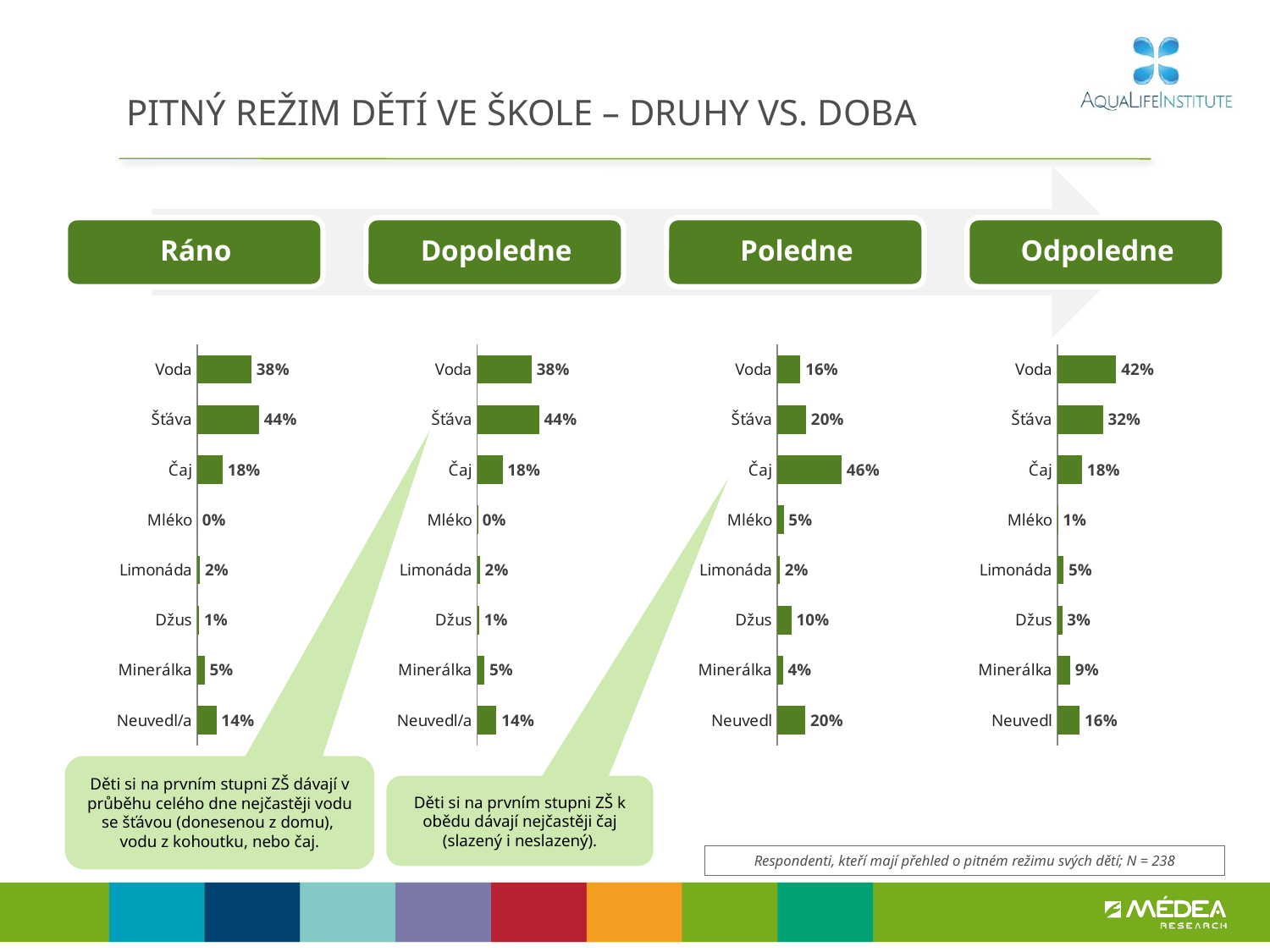
In the Dopoledne chart, what is the value for Neuvedl/a? 14% In the Odpoledne chart, what is the value for Voda? 42% In the Poledne chart, which is larger, Voda or Štáva? Štáva In the Odpoledne chart, what is the difference between Voda and Štáva? 10% In the Poledne chart, which category has the highest value? Čaj How many charts are shown on the slide? 4 In the Ráno chart, which category has the lowest value? Mléko In the Poledne chart, what is the difference between Džus and Minerálka? 6% In the Poledne chart, what is the value for Čaj? 46% What kind of chart is used for the Ráno data? Bar chart How many categories does the Odpoledne chart show? 8 In the Ráno chart, what is the value for Štáva? 44%